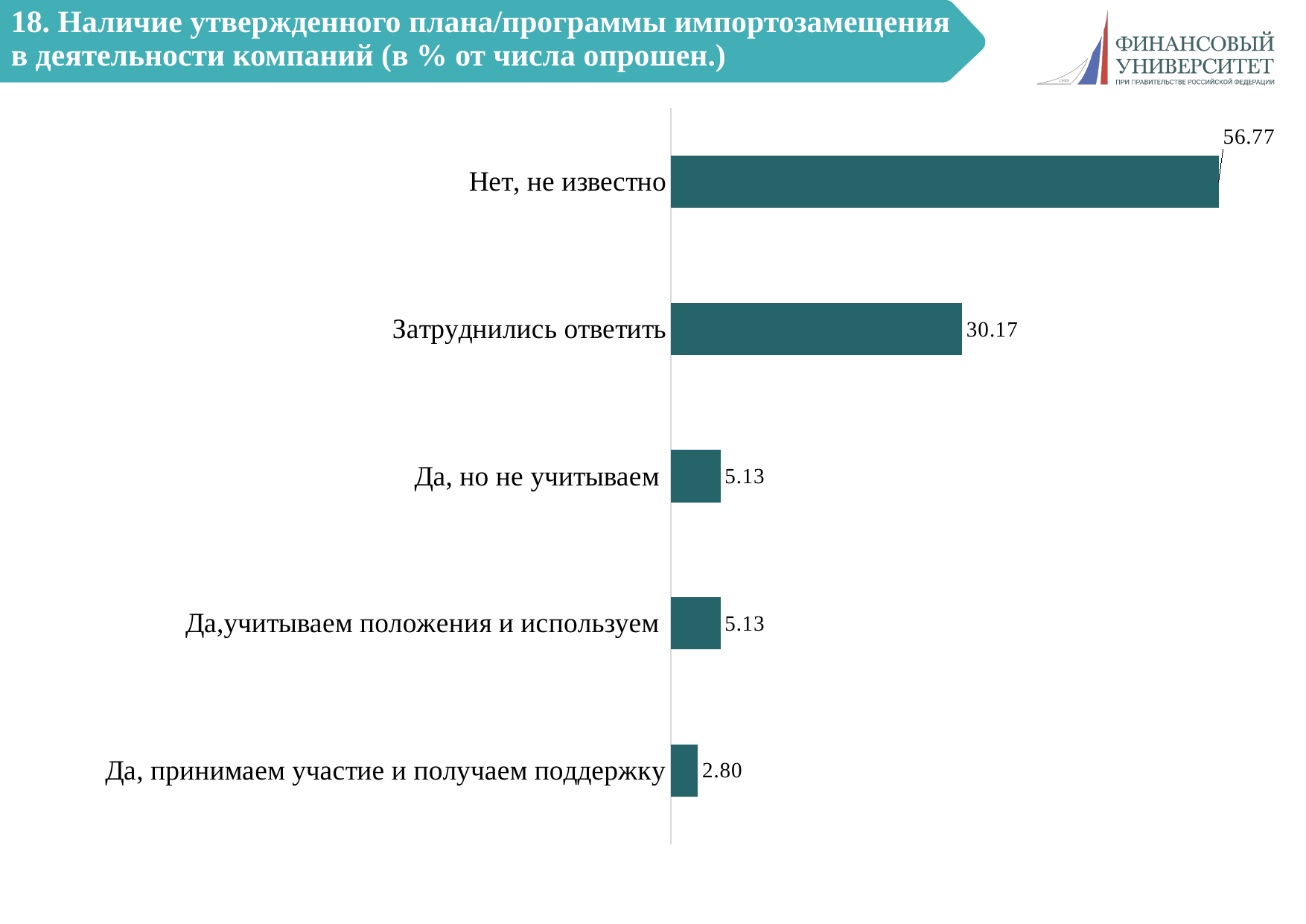
Which category has the lowest value? Да, принимаем участие и получаем поддержку What is the difference between the values for "Да, но не учитываем" and "Да, принимаем участие и получаем поддержку"? 2.33 Do the values for "Да, но не учитываем" and "Да,учитываем положения и используем" differ? No, both are 5.13 What is the value for "Да, принимаем участие и получаем поддержку"? 2.80 What is the value for "Затруднились ответить"? 30.17 Which category has the highest value? Нет, не известно What is the value for "Нет, не известно"? 56.77 What kind of chart is shown on the slide? Bar chart How many categories are shown in the chart? 5 What is the difference between the values for "Нет, не известно" and "Затруднились ответить"? 26.60 Which is larger: the value for "Затруднились ответить" or the value for "Да, но не учитываем"? Затруднились ответить What is the value for "Да, но не учитываем"? 5.13